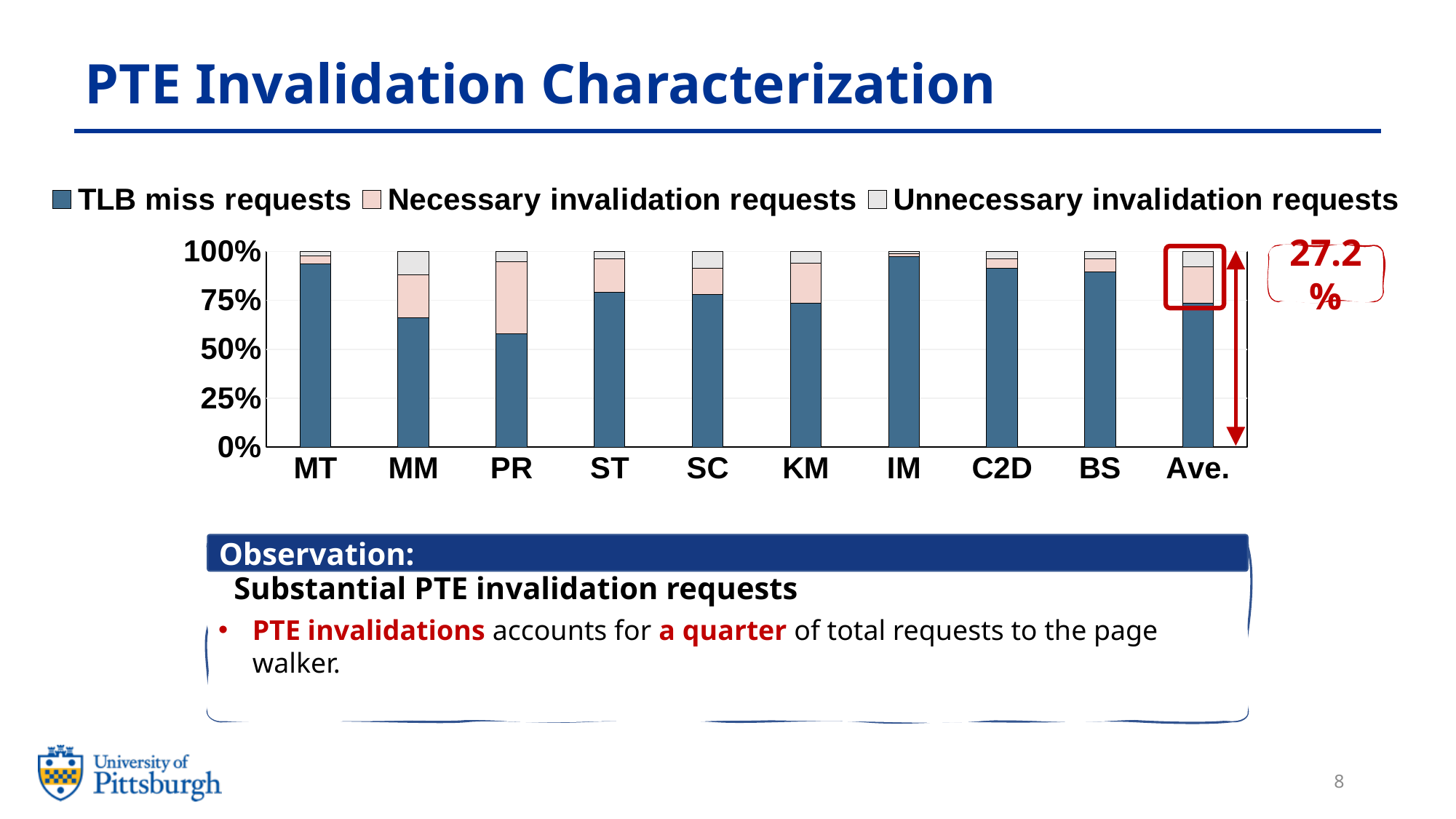
Which legend entry is shown in dark blue? TLB miss requests What is the total height of each stacked bar on the chart? 100% How many series does the chart legend list? 3 Which has a larger share of TLB miss requests, MM or MT? MT Which category has the lowest share of TLB miss requests? PR Is the TLB miss requests share for MM greater or less than 75%? less What percentage is annotated in red next to the Ave. bar? 27.2% What kind of chart is shown on the slide? Stacked bar chart Is the TLB miss requests share for PR greater or less than 75%? less How many categories are shown along the x axis of the chart? 10 Which has a larger share of TLB miss requests, PR or IM? IM Is the TLB miss requests share for IM greater or less than 75%? greater